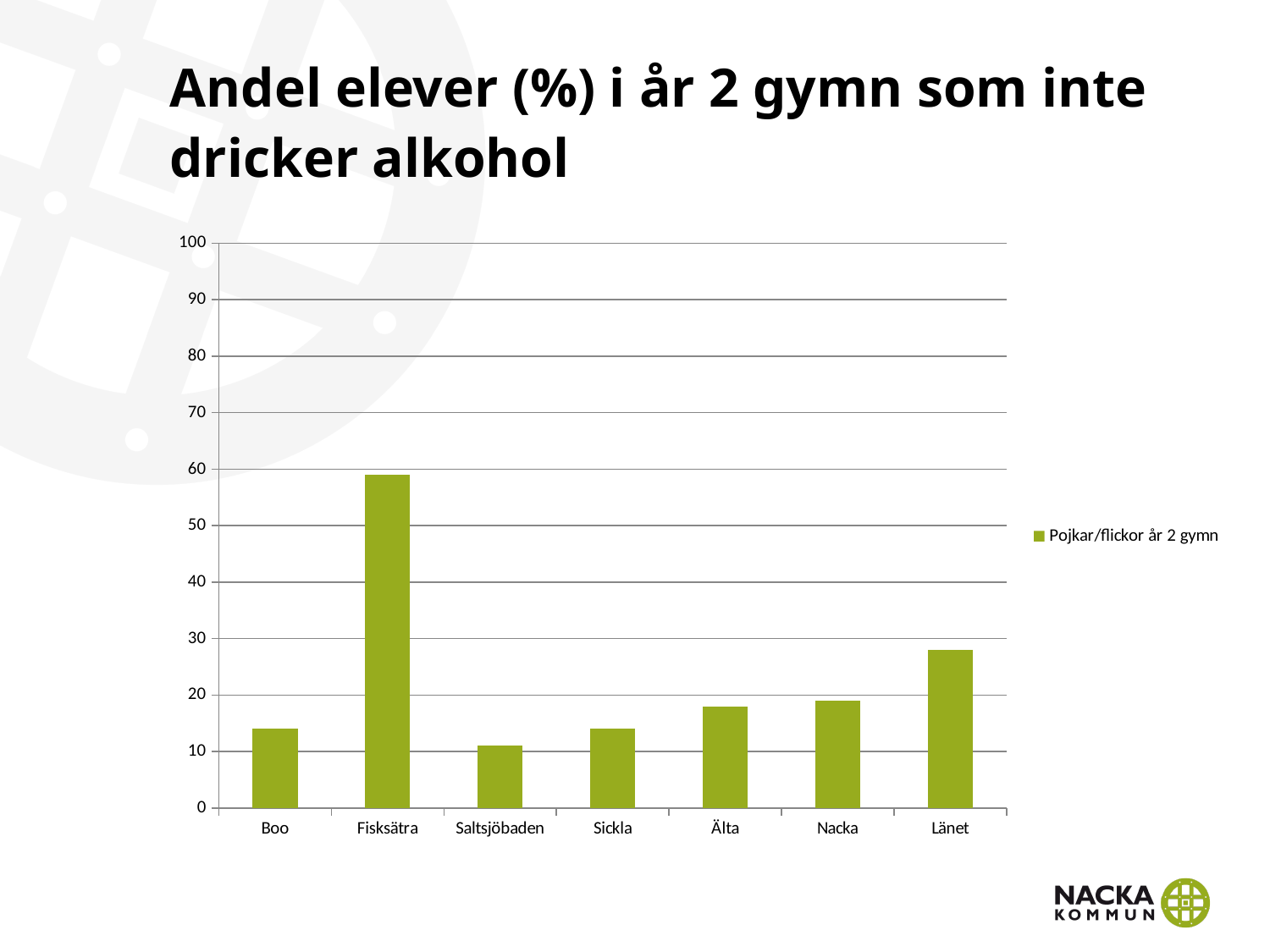
Which is larger, the value for Fisksätra or the value for Länet? Fisksätra Is the value for Boo greater or less than 20? less What kind of chart is shown on the slide? bar chart Which category has the lowest value? Saltsjöbaden Is the value for Fisksätra greater or less than 50? greater What is the legend entry for the series in the chart? Pojkar/flickor år 2 gymn Is the value for Länet greater or less than 20? greater Which is larger, the value for Länet or the value for Nacka? Länet Which category has the highest value? Fisksätra How many categories are shown on the x axis of the chart? 7 How many series does the legend list? 1